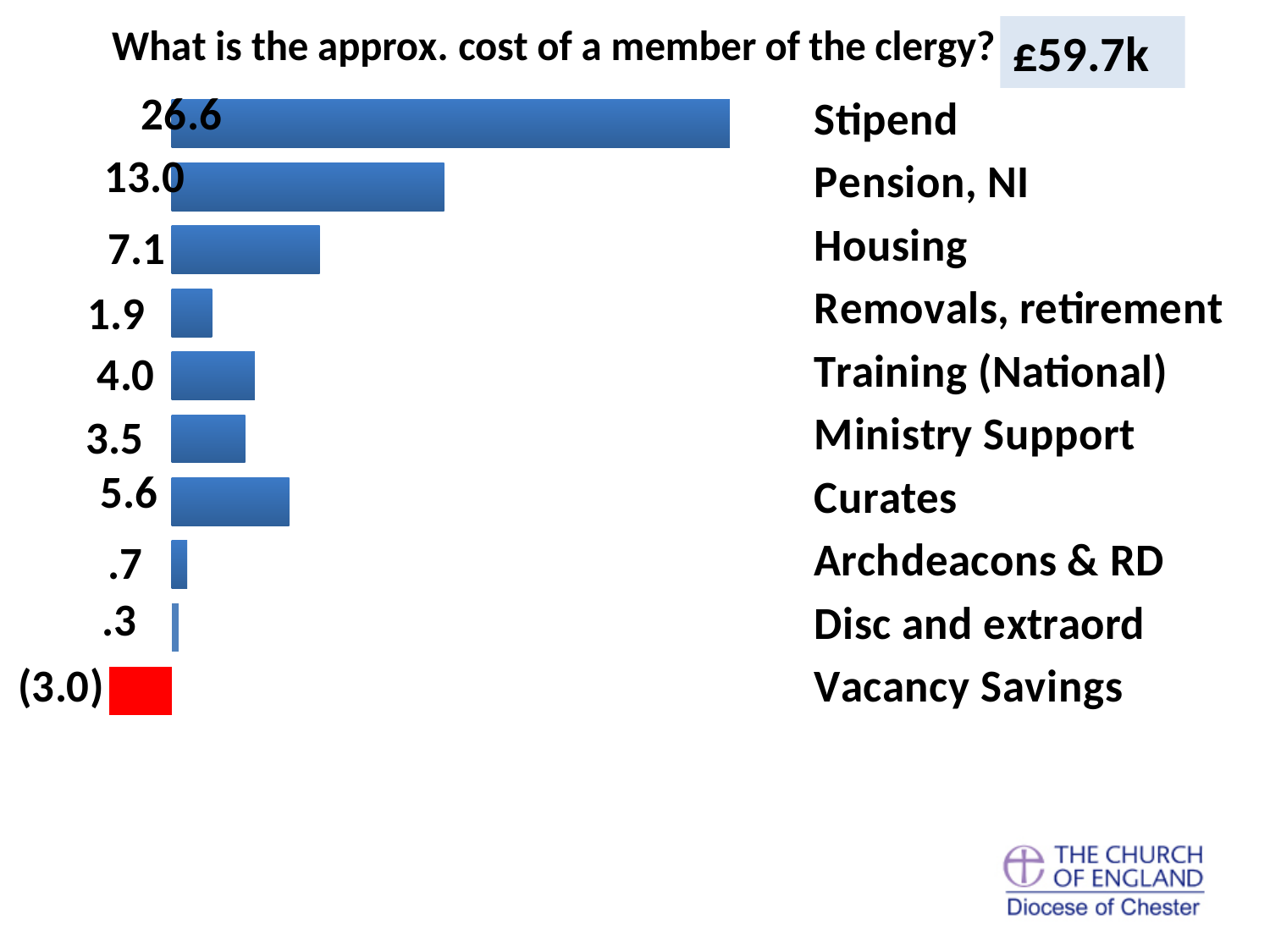
What is the value shown for Curates? 5.6 Which category has the largest bar? Stipend How many categories are shown in the chart? 10 What is the value shown for Pension, NI? 13.0 What kind of chart is shown on the slide? Bar chart Which is larger, the value for Training (National) or the value for Ministry Support? Training (National) Which category has the smallest positive value? Disc and extraord What is the difference between the values for Stipend and Pension, NI? 13.6 What is the difference between the values for Housing and Curates? 1.5 What is the value shown for Vacancy Savings? (3.0) What is the value shown for Stipend? 26.6 Which category's bar is coloured red? Vacancy Savings